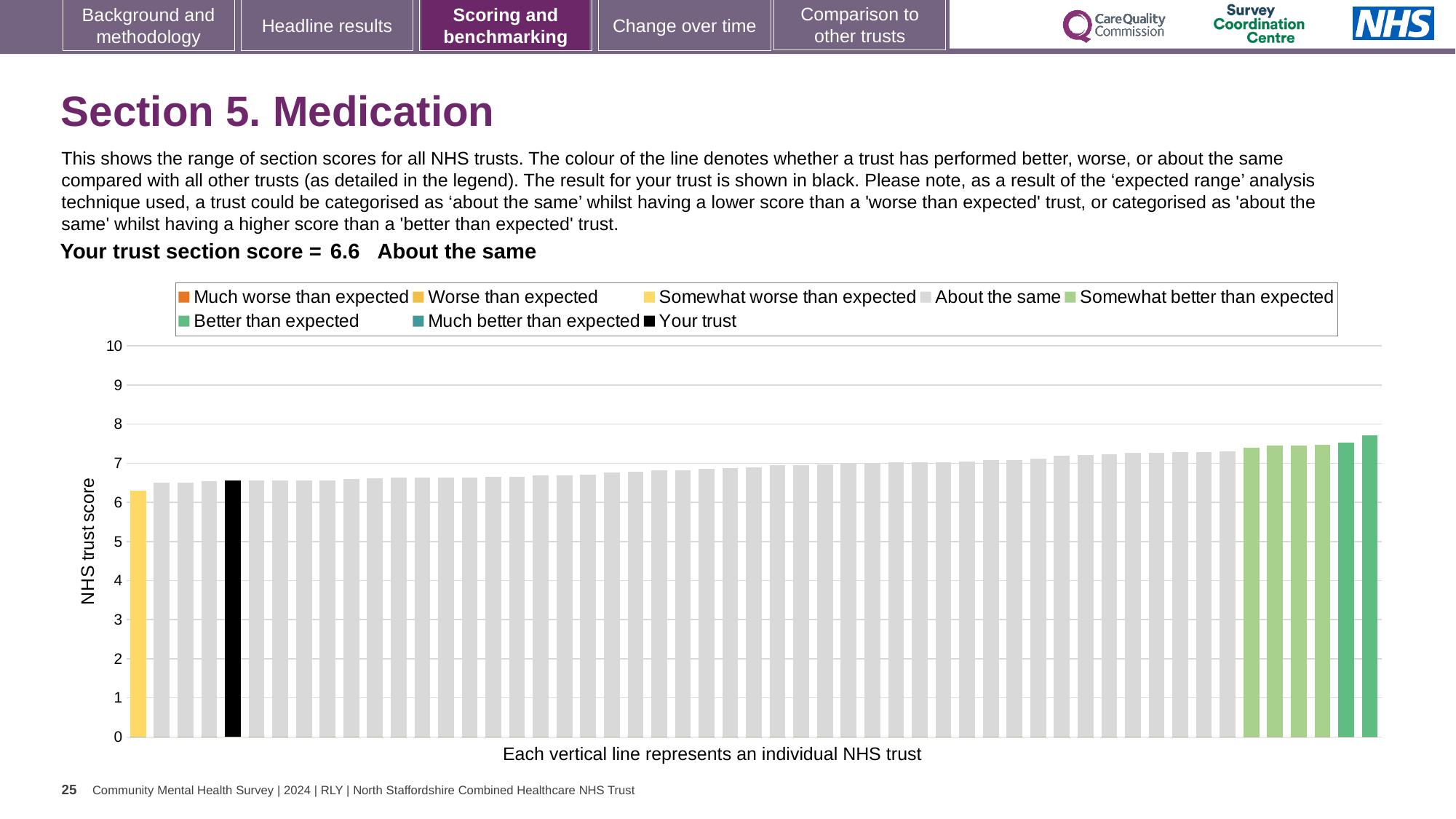
Is the leftmost bar higher or lower than the rightmost bar? lower Is the value of the leftmost (yellow) bar greater or less than 7? less Is the value of the tallest bar greater or less than 8? less Is the value of the black bar for your trust greater or less than 6? greater Which category is your trust placed in for the Medication section? About the same What kind of chart is shown on the slide? bar chart Do the bar values rise or fall from left to right along the x axis? rise How many entries does the chart legend list? 8 What is the label on the vertical axis of the chart? NHS trust score How many bars are coloured green (better than expected categories) in the chart? 6 What is the section score for your trust shown on the slide? 6.6